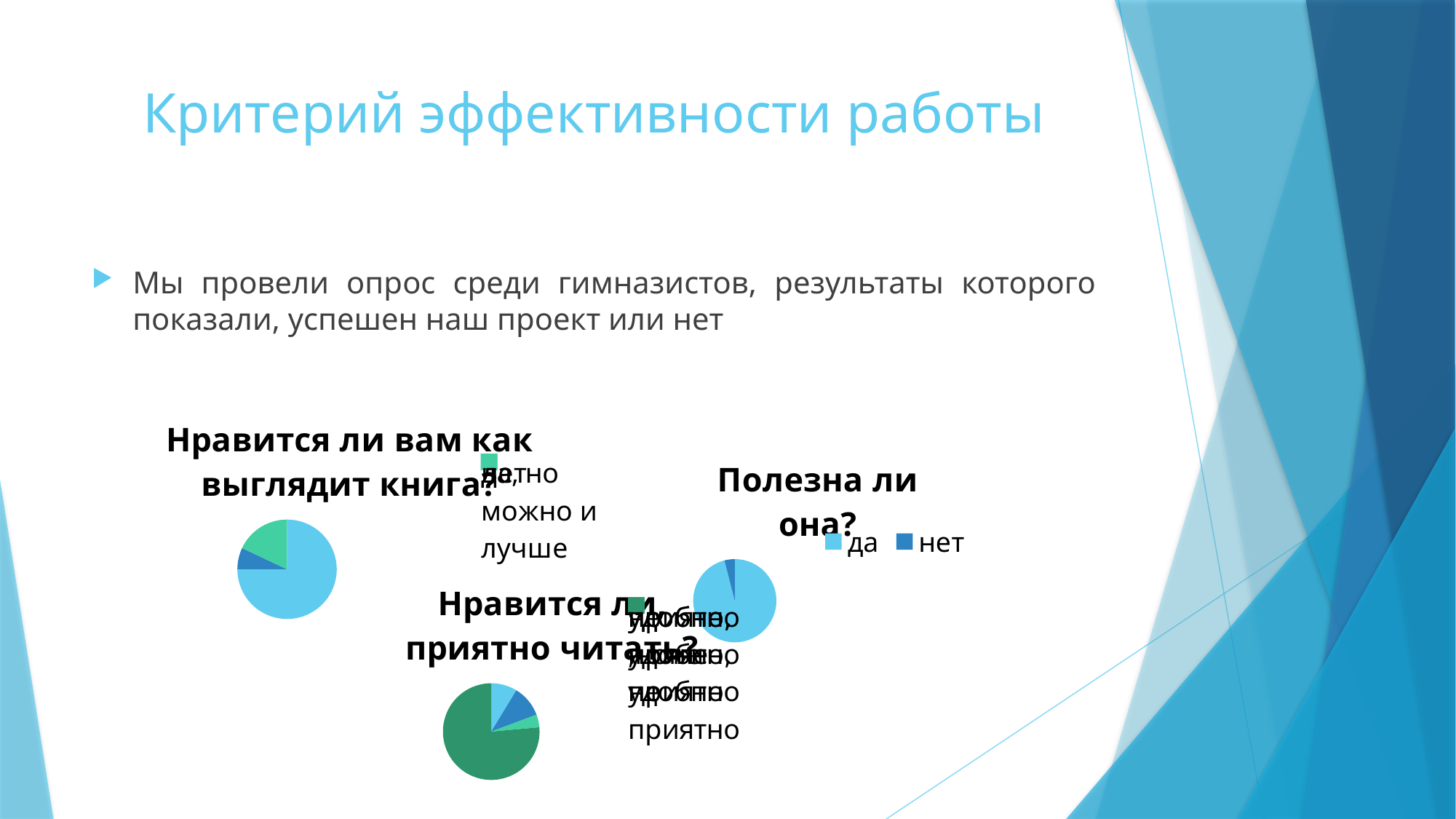
How many pie charts are shown on the slide? 3 In the chart "Полезна ли она?", which is larger, the share for "да" or the share for "нет"? да In the chart "Нравится ли вам как выглядит книга?", how many slices does the pie have? 3 What kind of chart is "Полезна ли она?"? pie chart In the chart "Полезна ли она?", which category has the smallest share of the pie? нет In the chart "Полезна ли она?", how many entries does the legend list? 2 In the chart "Полезна ли она?", what are the legend entries? да, нет In the chart "Нравится ли вам как выглядит книга?", what colour is the largest slice? light blue What kind of chart is "Нравится ли вам как выглядит книга?"? pie chart In the chart "Полезна ли она?", which category has the largest share of the pie? да